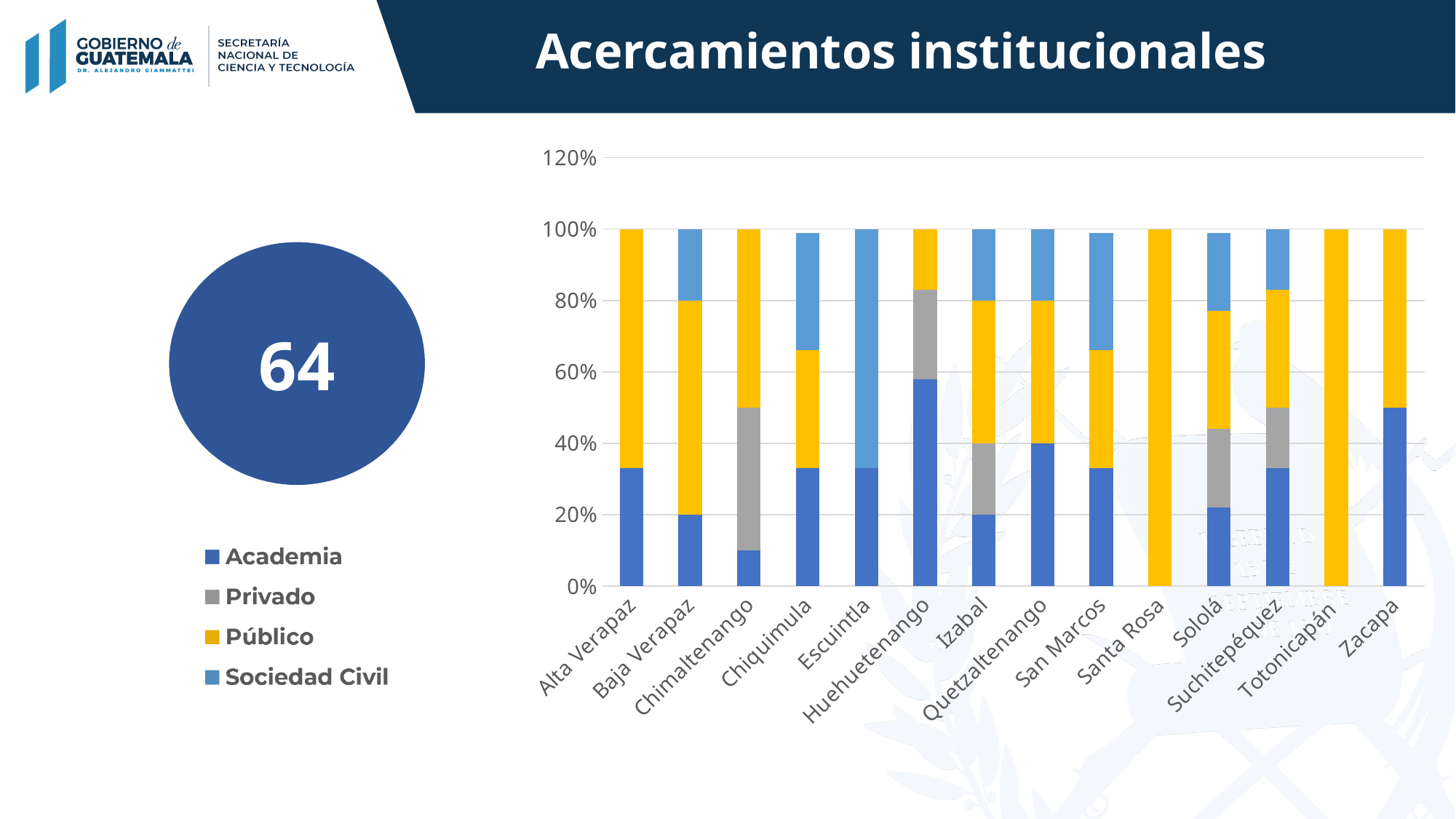
Is the Academia share for Chimaltenango greater or less than 20%? less Is the Academia share for Huehuetenango greater or less than 40%? greater How many series does the chart legend list? 4 Which department has the largest Academia share? Huehuetenango What kind of chart is shown on the slide? Stacked bar chart Is the Sociedad Civil share for Escuintla greater or less than 60%? greater Which department has the largest Privado share? Chimaltenango What number is shown in the large circle to the left of the chart? 64 Which has the larger Academia share, Huehuetenango or Baja Verapaz? Huehuetenango How many departments (categories) are shown on the x axis of the chart? 14 Which series are listed in the chart legend? Academia, Privado, Público, Sociedad Civil Which department has the largest Sociedad Civil share? Escuintla